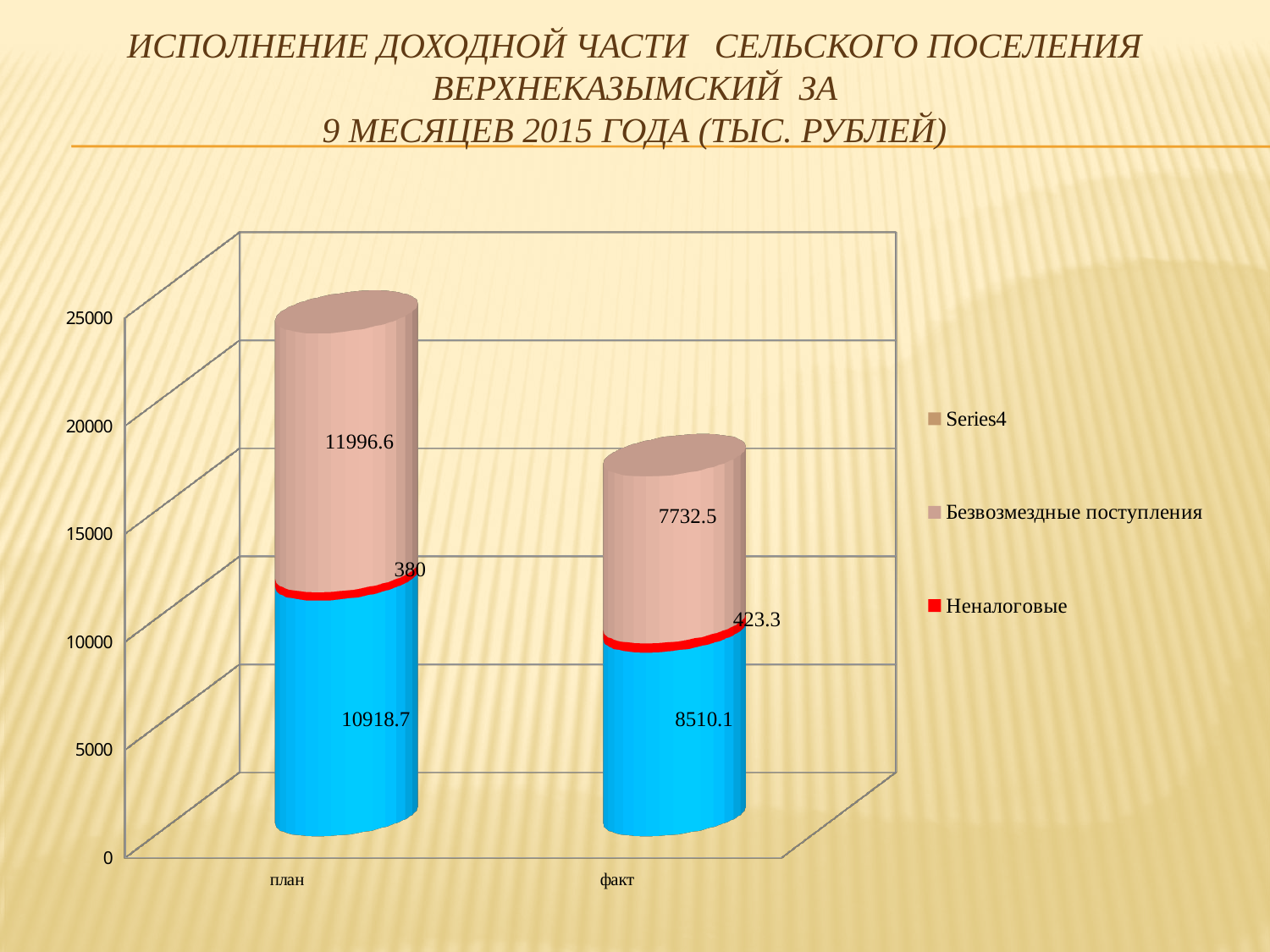
What is the difference between the Безвозмездные поступления values for план and факт? 4264.1 What is the value of the bottom blue segment for план? 10918.7 How many categories are shown on the x axis? 2 What is the value of Неналоговые for факт? 423.3 What is the difference between the Неналоговые values for факт and план? 43.3 What is the value of the bottom blue segment for факт? 8510.1 What is the total of the stacked bar for факт? 16665.9 What kind of chart is shown on the slide? Stacked bar chart What is the total of the stacked bar for план? 23295.3 Which category has the larger Неналоговые value, план or факт? факт What is the value of Безвозмездные поступления for факт? 7732.5 What is the value of Безвозмездные поступления for план? 11996.6